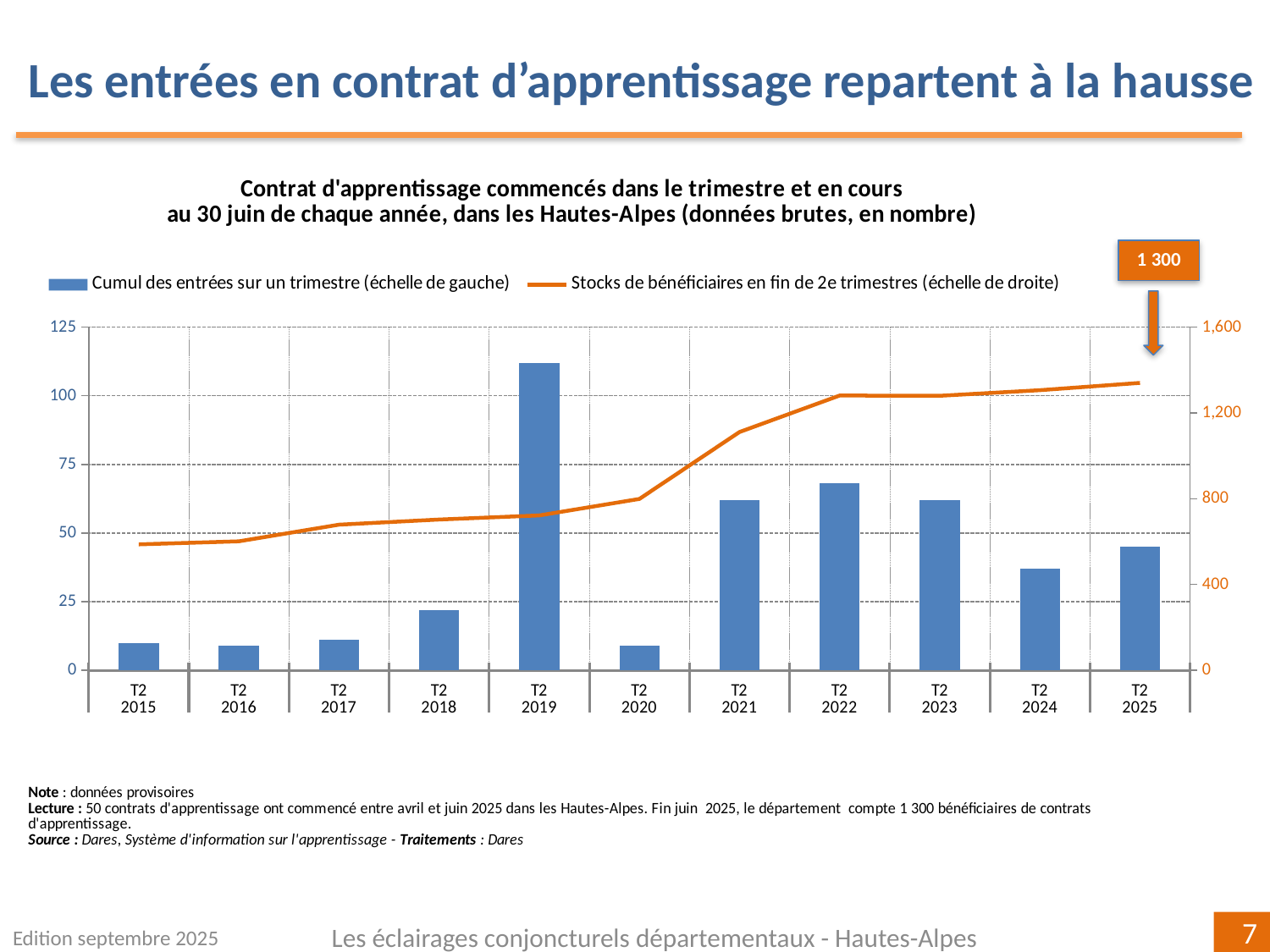
Is the bar value for T2 2019 greater or less than 100? greater What kind of chart is shown on the slide? A combined bar and line chart Which quarter has the highest bar for 'Cumul des entrées sur un trimestre'? T2 2019 Is the bar value for T2 2021 greater or less than 50? greater Does the line for 'Stocks de bénéficiaires en fin de 2e trimestres' generally rise or fall from T2 2015 to T2 2025? Rise What is the value of the stock of beneficiaries (Stocks de bénéficiaires) at T2 2025, as shown in the callout? 1 300 Is the stock of beneficiaries at T2 2015 greater or less than 800 on the right-hand axis? less How many quarters (categories) are shown on the x axis? 11 How many series does the legend list? 2 Which bar is taller, T2 2024 or T2 2025? T2 2025 What colour is the line for 'Stocks de bénéficiaires en fin de 2e trimestres'? Orange